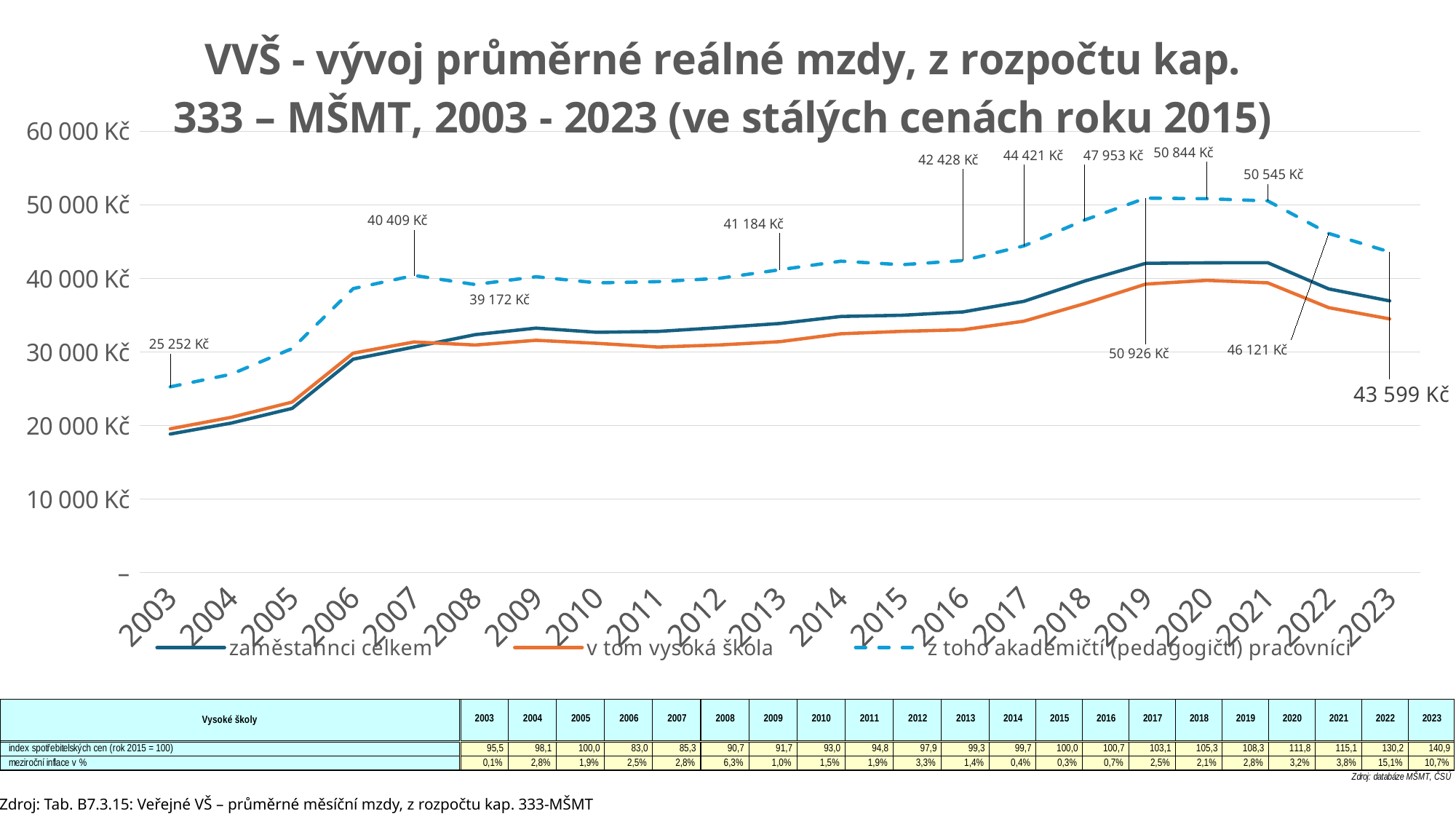
What kind of chart is shown on the slide? line chart What is the value labelled for 'z toho akademičtí (pedagogičtí) pracovníci' in 2003? 25 252 Kč What is the value labelled for 'z toho akademičtí (pedagogičtí) pracovníci' in 2023? 43 599 Kč How many series does the chart legend list? 3 By how much did the labelled value for academic staff increase from 2017 (44 421 Kč) to 2018 (47 953 Kč)? 3 532 Kč What is the value labelled for 'z toho akademičtí (pedagogičtí) pracovníci' in 2018? 47 953 Kč Does the 'z toho akademičtí (pedagogičtí) pracovníci' line rise or fall from 2021 to 2023? fall How many years are shown on the x axis of the chart? 21 What is the value labelled for 'z toho akademičtí (pedagogičtí) pracovníci' in 2007? 40 409 Kč What is the difference between the labelled academic staff values for 2022 (46 121 Kč) and 2023 (43 599 Kč)? 2 522 Kč In 2023, which series has the higher value: 'zaměstnanci celkem' or 'v tom vysoká škola'? zaměstnanci celkem Is the value for 'zaměstnanci celkem' in 2019 greater or less than 40 000 Kč? greater